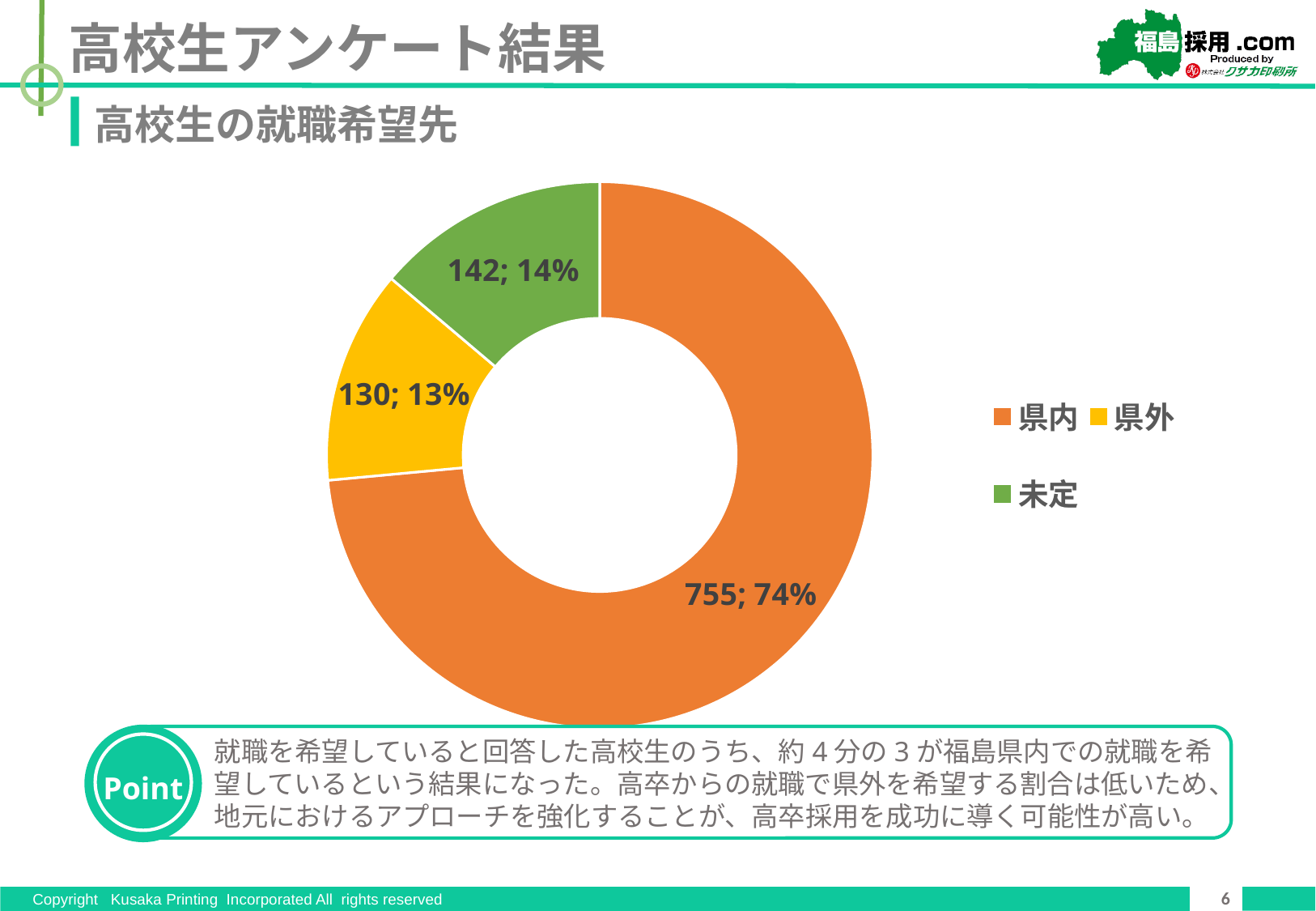
What is the count for 県内? 755 What is the count for 未定? 142 How many entries does the legend list? 3 What kind of chart is shown on the slide? Pie chart (donut) What is the count for 県外? 130 What is the difference between the counts for 県内 and 県外? 625 Which category has the smallest slice? 県外 What share of the pie does 県内 represent? 74% Which category has the largest slice? 県内 What share of the pie does 未定 represent? 14% Which colour represents 未定 in the chart? Green How many categories does the pie chart show? 3